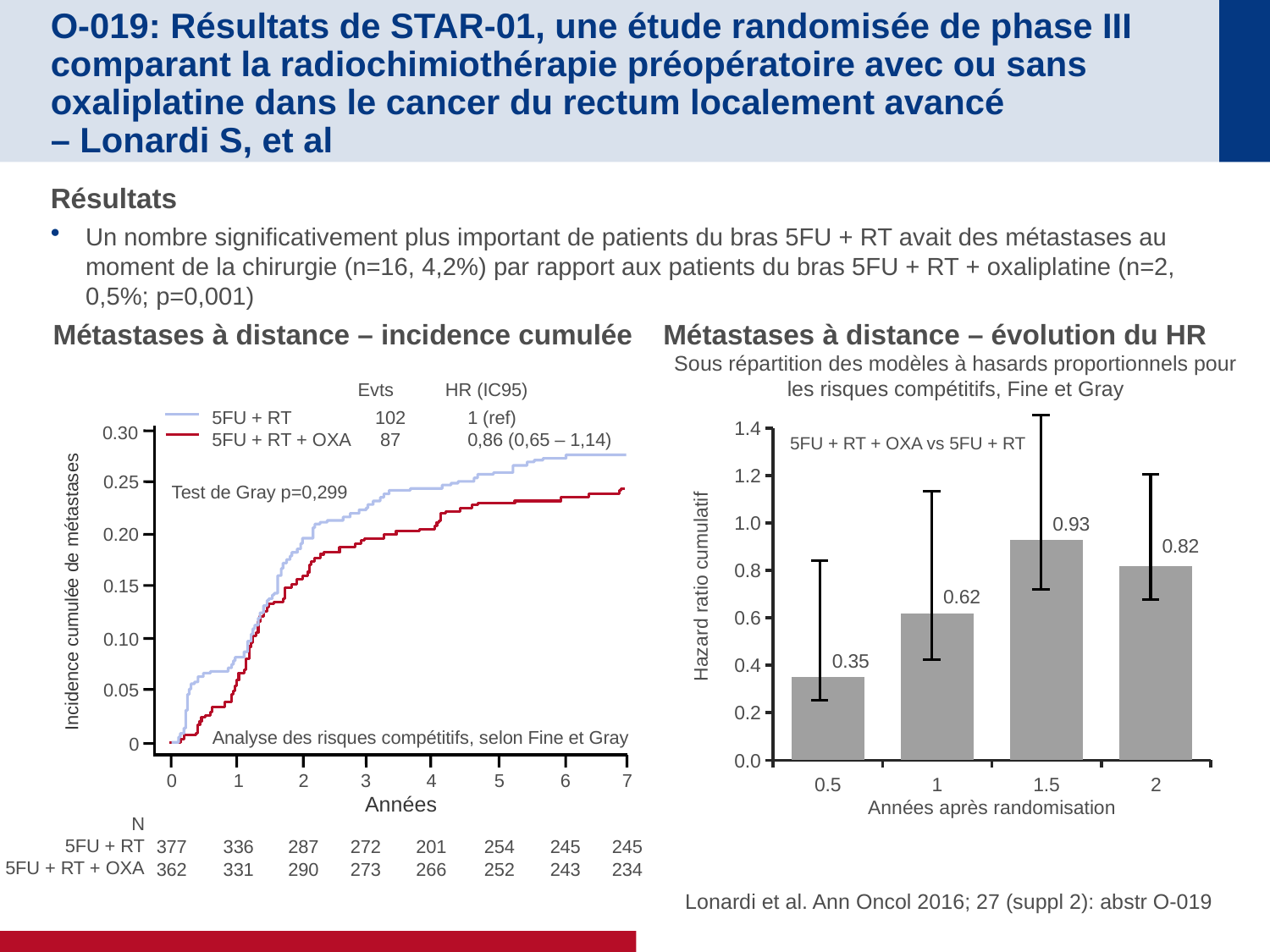
In the chart 'Métastases à distance – évolution du HR', how many bars are plotted? 4 In the chart 'Métastases à distance – évolution du HR', what is the hazard ratio at 1.5 years after randomisation? 0.93 In the chart 'Métastases à distance – incidence cumulée', what is the HR (IC95) shown for 5FU + RT + OXA? 0,86 (0,65 – 1,14) In the chart 'Métastases à distance – évolution du HR', is the hazard ratio at 0.5 years greater or less than 0.4? less In the chart 'Métastases à distance – évolution du HR', what is the hazard ratio at 0.5 years after randomisation? 0.35 In the chart 'Métastases à distance – évolution du HR', what is the difference between the hazard ratio at 1.5 years and at 0.5 years? 0.58 What kind of chart is 'Métastases à distance – évolution du HR'? bar chart In the chart 'Métastases à distance – évolution du HR', at which time point is the cumulative hazard ratio lowest? 0.5 In the chart 'Métastases à distance – incidence cumulée', how many series does the legend list? 2 In the chart 'Métastases à distance – incidence cumulée', which arm has the higher cumulative incidence of metastases at 7 years? 5FU + RT In the chart 'Métastases à distance – évolution du HR', at which time point is the cumulative hazard ratio highest? 1.5 In the chart 'Métastases à distance – incidence cumulée', how many events (Evts) are reported for the 5FU + RT arm? 102